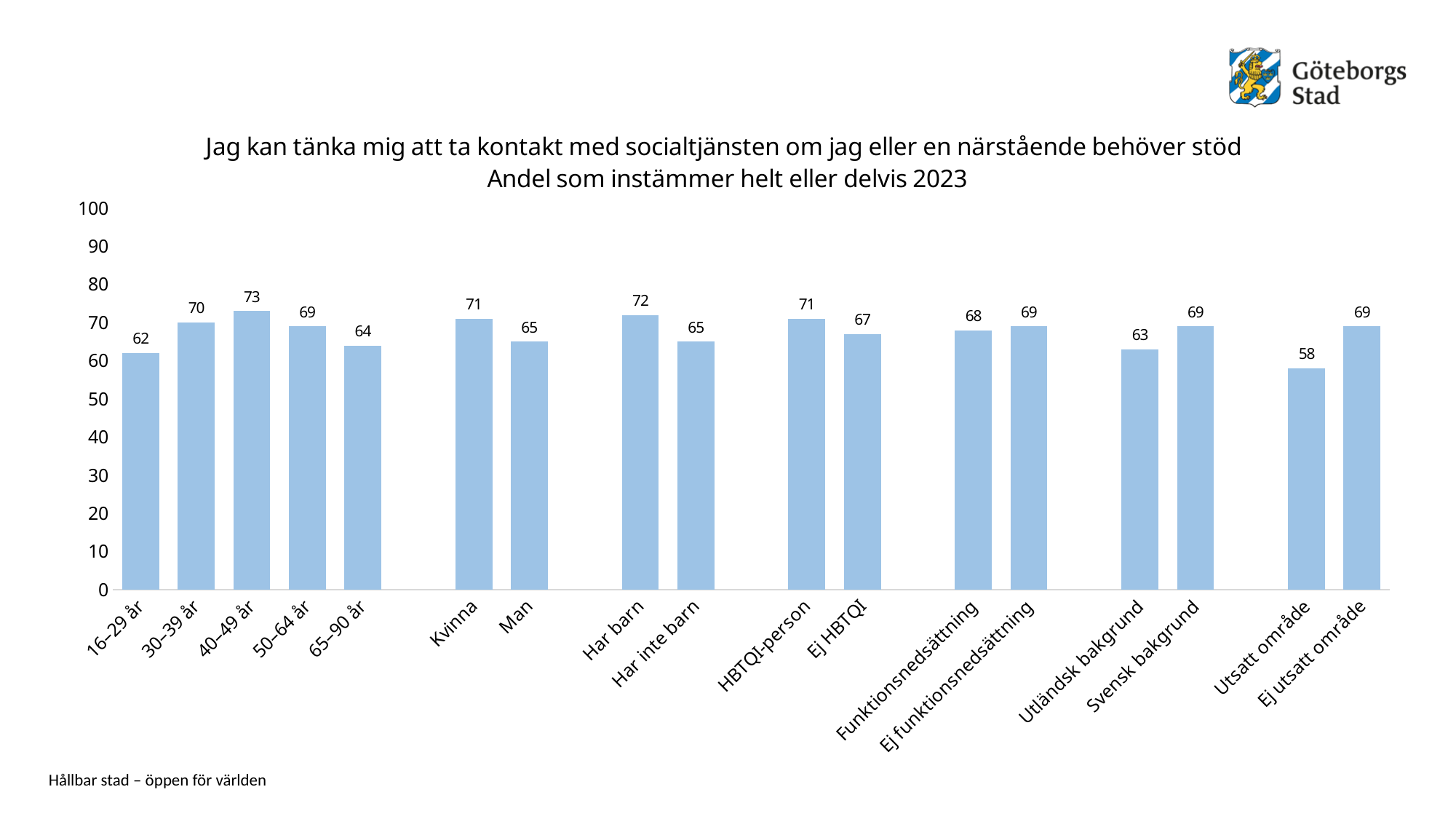
What is the difference between the values for Kvinna and Man? 6 Which category has the highest value? 40–49 år What is the value for Funktionsnedsättning? 68 Which category has the lowest value? Utsatt område Which is larger, the value for Har barn or the value for Har inte barn? Har barn What is the value for Har barn? 72 What kind of chart is shown on the slide? Bar chart What is the value for 40–49 år? 73 Which is larger, the value for Utländsk bakgrund or the value for Svensk bakgrund? Svensk bakgrund What is the difference between the values for Ej utsatt område and Utsatt område? 11 How many categories are shown on the x axis? 18 What is the value for Utsatt område? 58